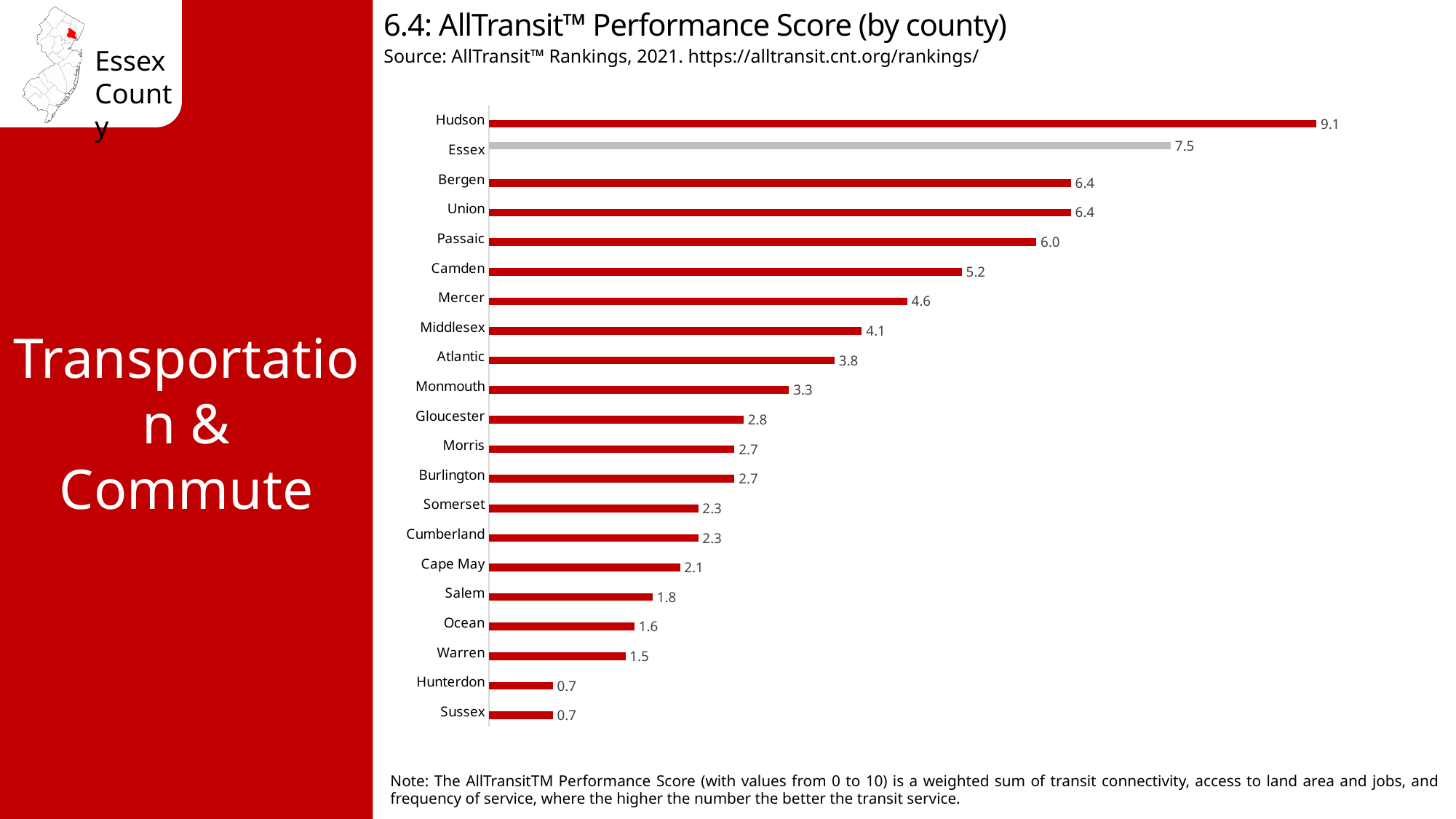
What is the difference between the scores of Bergen and Monmouth counties? 3.1 Which county's bar is shown in grey rather than red? Essex What is the AllTransit Performance Score for Warren county? 1.5 Which county has the highest AllTransit Performance Score? Hudson What is the AllTransit Performance Score for Passaic county? 6.0 What is the AllTransit Performance Score for Essex county? 7.5 How many counties are shown in the chart? 21 What is the AllTransit Performance Score for Middlesex county? 4.1 What type of chart is used to show the AllTransit Performance Score by county? Bar chart What is the difference between the scores of Hudson and Essex counties? 1.6 Which county has a higher score, Camden or Mercer? Camden Which county has a higher score, Salem or Ocean? Salem